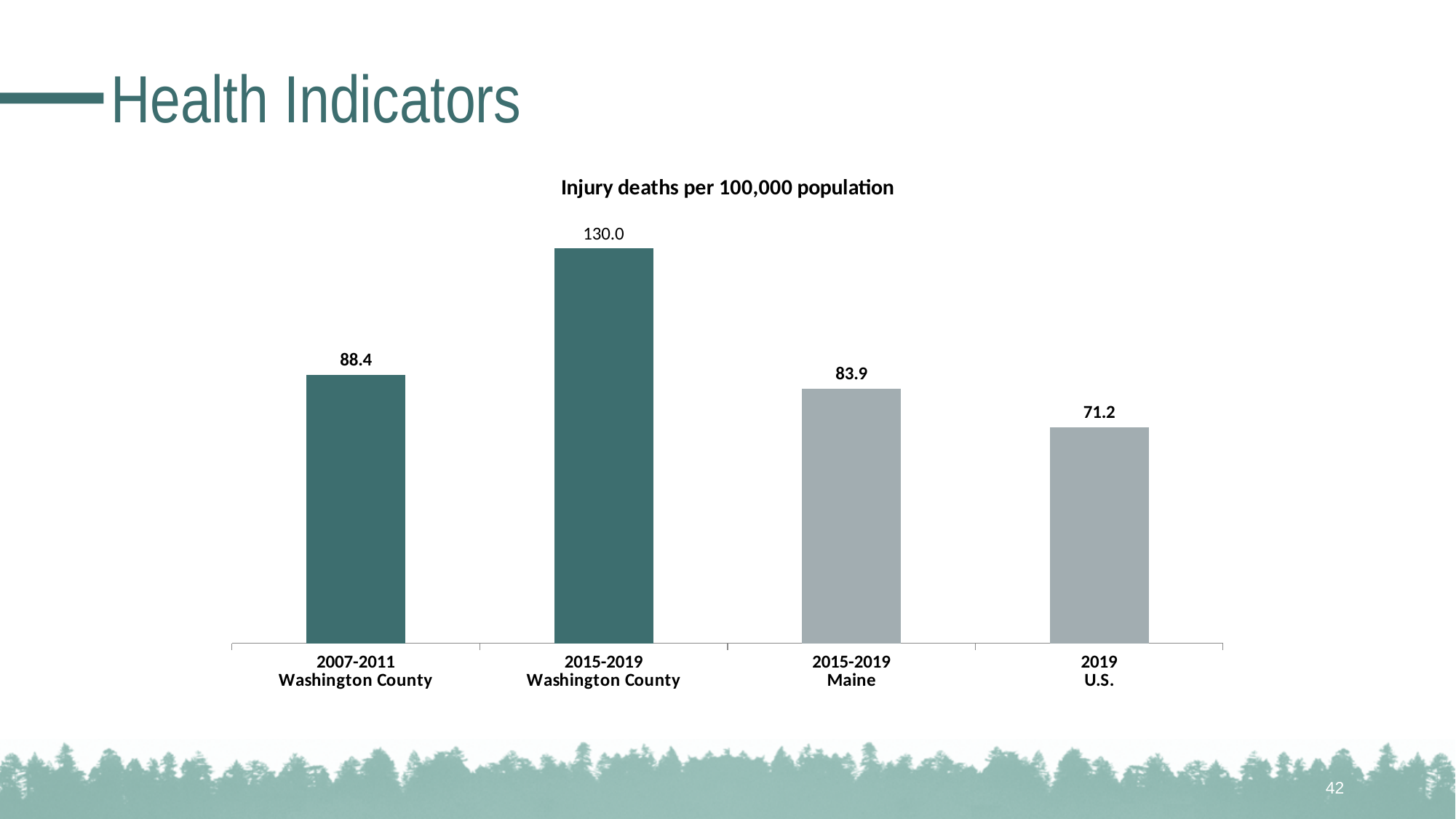
What is the difference between the 2015-2019 Maine value and the 2019 U.S. value? 12.7 Which category has the lowest value? 2019 U.S. What is the difference between the 2015-2019 Washington County value and the 2007-2011 Washington County value? 41.6 What is the value for 2015-2019 Washington County? 130.0 Which category has the highest value? 2015-2019 Washington County What is the value for 2007-2011 Washington County? 88.4 What is the value for 2019 U.S.? 71.2 Which is larger, the value for 2015-2019 Maine or the value for 2019 U.S.? 2015-2019 Maine What is the title of the chart? Injury deaths per 100,000 population What is the value for 2015-2019 Maine? 83.9 What kind of chart is shown on the slide? bar chart How many bars are shown in the chart? 4